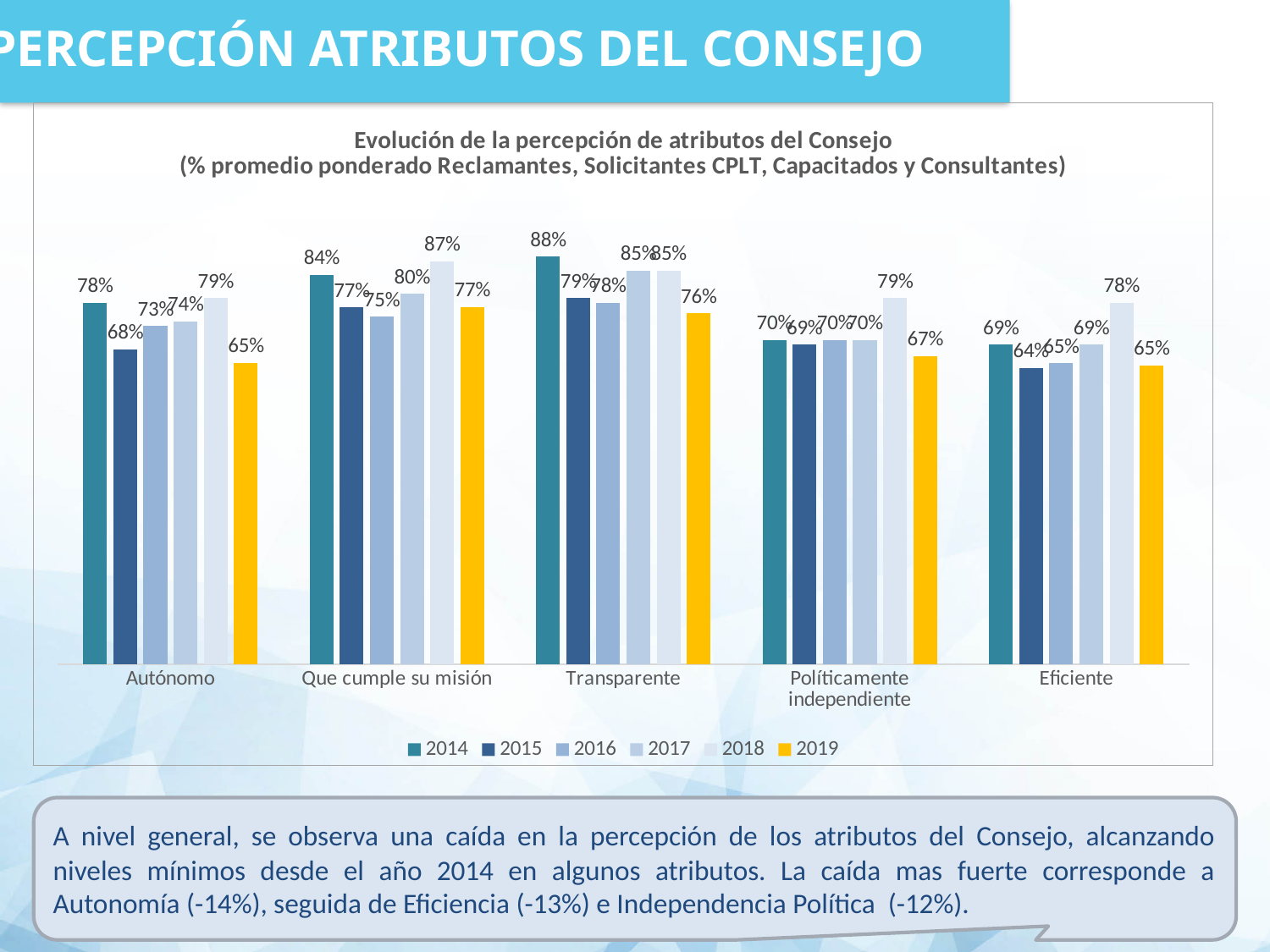
Which category has the highest value for the 2018 series? Que cumple su misión What is the value for 2018 in the Políticamente independiente category? 79% What is the difference between the 2014 and 2019 values for Transparente? 12 percentage points What is the value for 2014 in the Transparente category? 88% Which colour represents the 2019 series in the legend? Yellow Which category has the highest value for the 2014 series? Transparente What is the value for 2019 in the Autónomo category? 65% What kind of chart is shown on the slide? Bar chart How many categories are shown on the x axis? 5 How many series does the legend list? 6 What is the value for 2018 in the Que cumple su misión category? 87% Which is larger for Eficiente: the 2018 value or the 2019 value? 2018